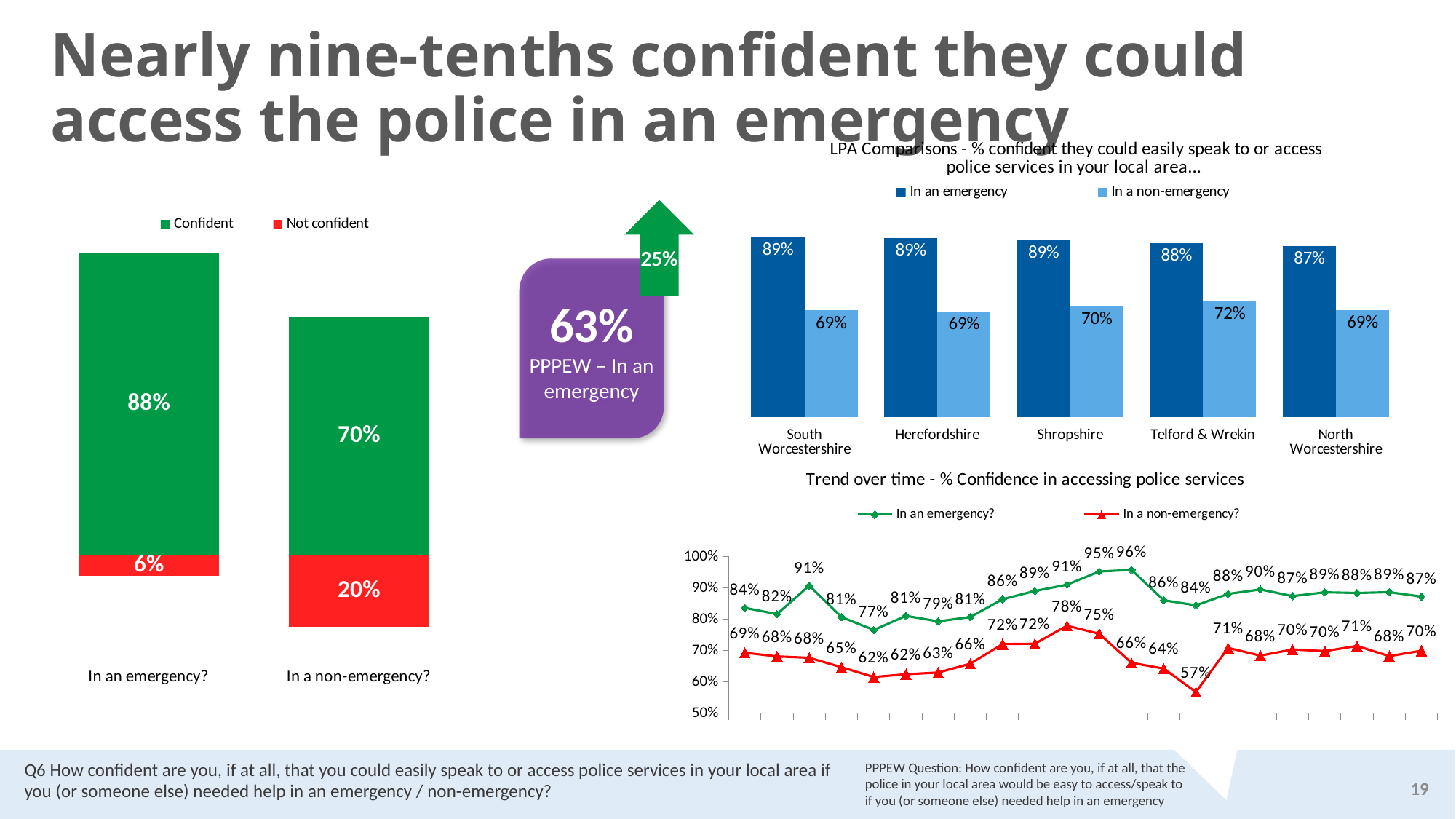
In the Trend over time chart, what is the highest value shown on the 'In an emergency?' line? 96% In the left-hand stacked bar chart, what is the combined total of the Confident and Not confident segments for 'In an emergency?'? 94% In the LPA Comparisons chart, what is the difference between the 'In an emergency' and 'In a non-emergency' values for Shropshire? 19% In the left-hand stacked bar chart, what percentage are confident they could access police in an emergency? 88% What type of chart is the Trend over time chart? Line chart In the LPA Comparisons chart, which area has the highest 'In a non-emergency' value? Telford & Wrekin In the LPA Comparisons chart, what is the 'In a non-emergency' value for Telford & Wrekin? 72% In the LPA Comparisons chart, which area has the lowest 'In an emergency' value? North Worcestershire In the LPA Comparisons chart, how many areas are compared? 5 In the Trend over time chart, what is the lowest value shown on the 'In a non-emergency?' line? 57% In the left-hand stacked bar chart, what is the difference between the Confident values for 'In an emergency?' and 'In a non-emergency?'? 18% In the left-hand stacked bar chart, what percentage are not confident in a non-emergency? 20%